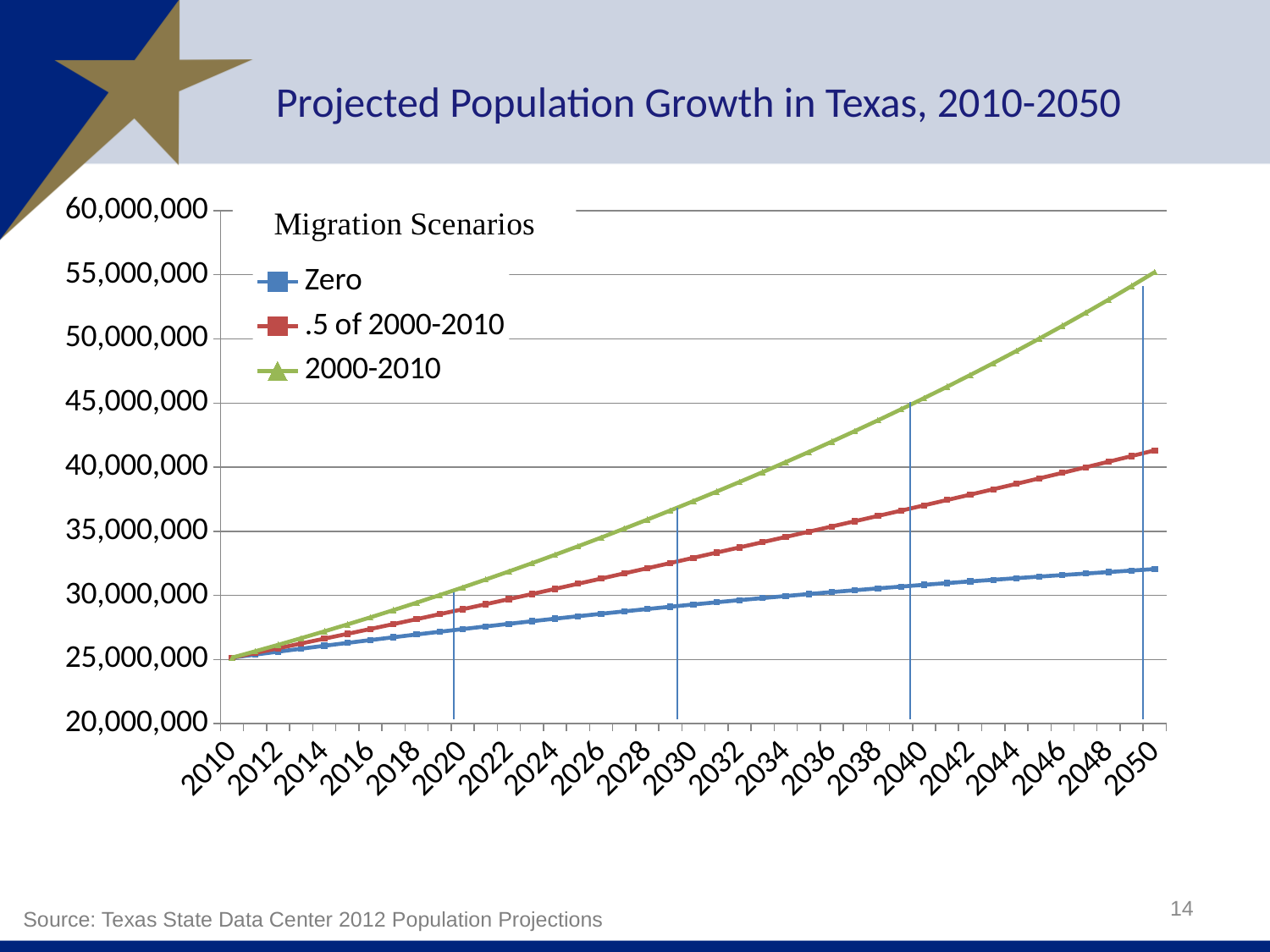
In 2040, which is larger: the value for the 2000-2010 scenario or the value for the Zero scenario? 2000-2010 What kind of chart is shown on the slide? Line chart What is the title of the chart? Projected Population Growth in Texas, 2010-2050 How many years are labeled on the x axis? 21 Is the value for the Zero scenario in 2030 greater or less than 30,000,000? less Do the values for the 2000-2010 scenario rise or fall from 2010 to 2050? Rise Which migration scenario has the highest projected population in 2050? 2000-2010 How many series does the legend list? 3 Is the value for the .5 of 2000-2010 scenario in 2040 greater or less than 35,000,000? greater Which migration scenario has the lowest projected population in 2050? Zero Is the value for the 2000-2010 scenario in 2030 greater or less than 35,000,000? greater What is the title shown above the legend entries? Migration Scenarios